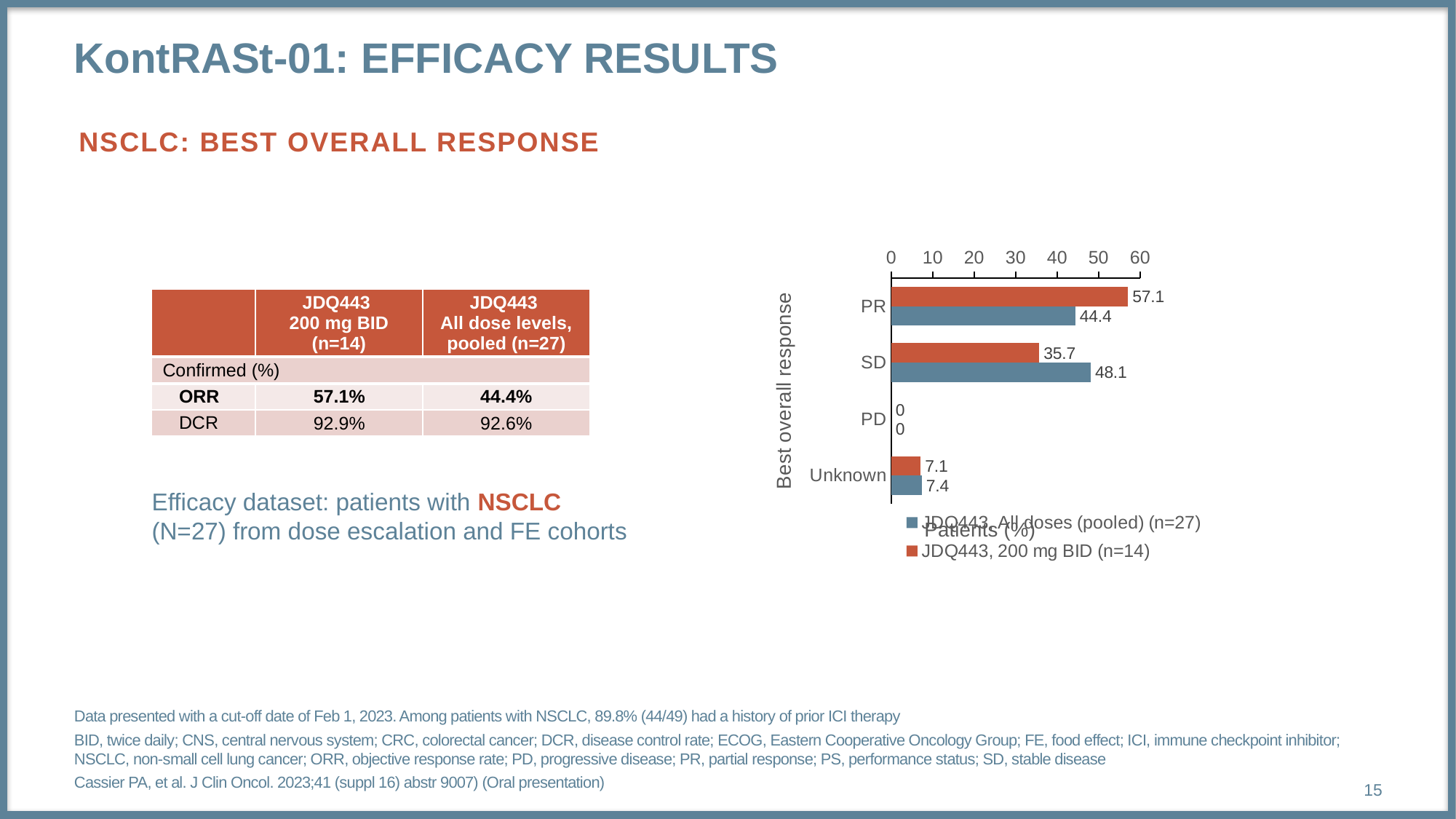
What is the value for PD in the JDQ443, All doses (pooled) (n=27) series? 0 Which best overall response category has the highest value in the JDQ443, 200 mg BID (n=14) series? PR What is the value for SD in the JDQ443, All doses (pooled) (n=27) series? 48.1 For SD, which series has the larger value: JDQ443, 200 mg BID (n=14) or JDQ443, All doses (pooled) (n=27)? JDQ443, All doses (pooled) (n=27) What is the value for Unknown in the JDQ443, 200 mg BID (n=14) series? 7.1 How many series does the chart legend list? 2 Which best overall response category has the highest value in the JDQ443, All doses (pooled) (n=27) series? SD What type of chart is shown on the slide? Bar chart How many best overall response categories are shown on the chart? 4 What is the label of the x axis of the chart? Patients (%) What is the value for PR in the JDQ443, 200 mg BID (n=14) series? 57.1 What is the difference between the PR values for the JDQ443, 200 mg BID (n=14) series and the JDQ443, All doses (pooled) (n=27) series? 12.7